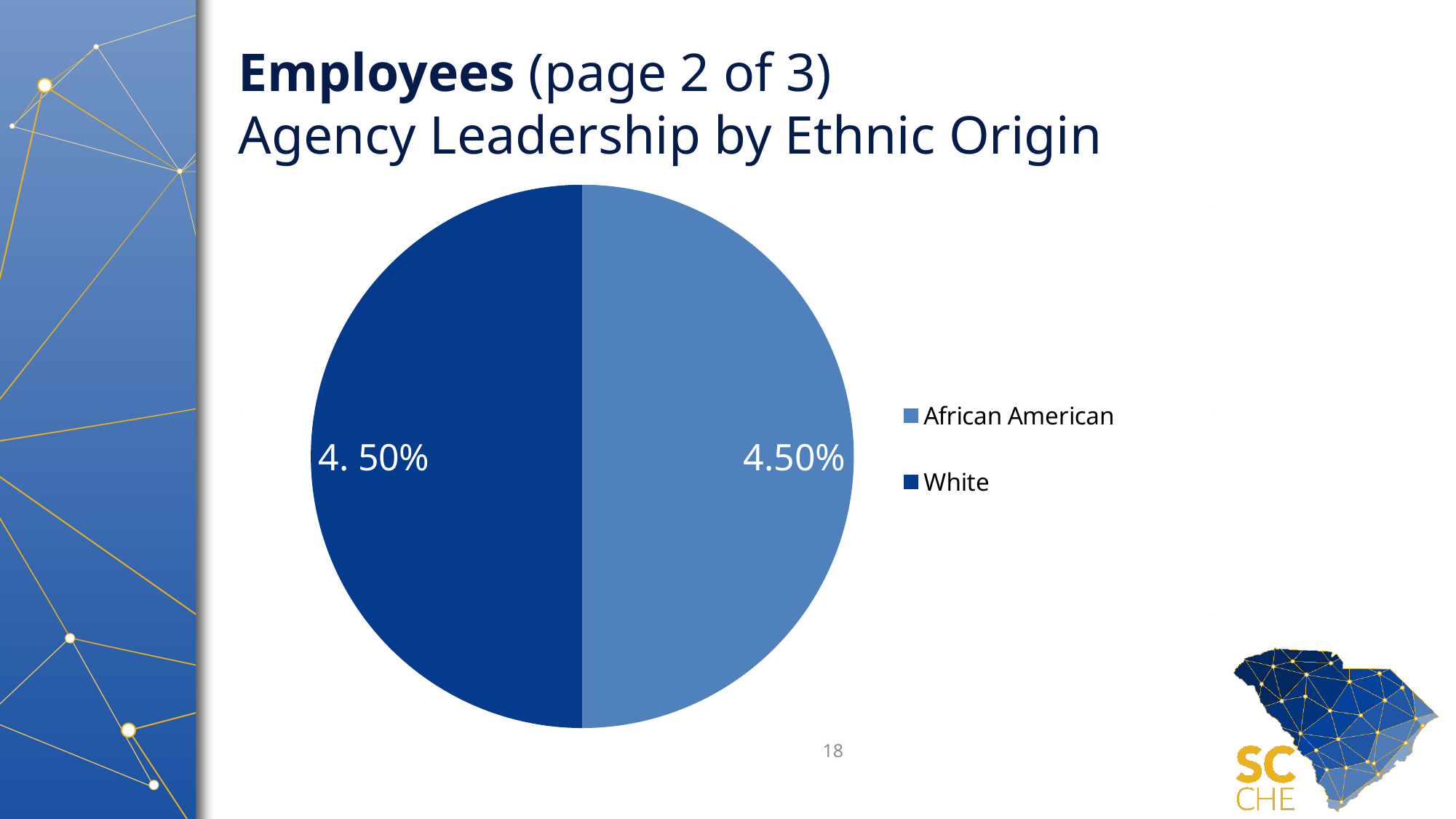
What is the label shown on the White slice of the pie chart? 4. 50% How many slices does the pie chart have? 2 Do the African American and White slices of the pie chart appear to be the same size? Yes Which categories are listed in the legend of the pie chart? African American and White How many entries does the legend of the pie chart list? 2 What is the label shown on the African American slice of the pie chart? 4.50% What is the subtitle of the chart on the slide? Agency Leadership by Ethnic Origin What kind of chart is shown on the slide? Pie chart